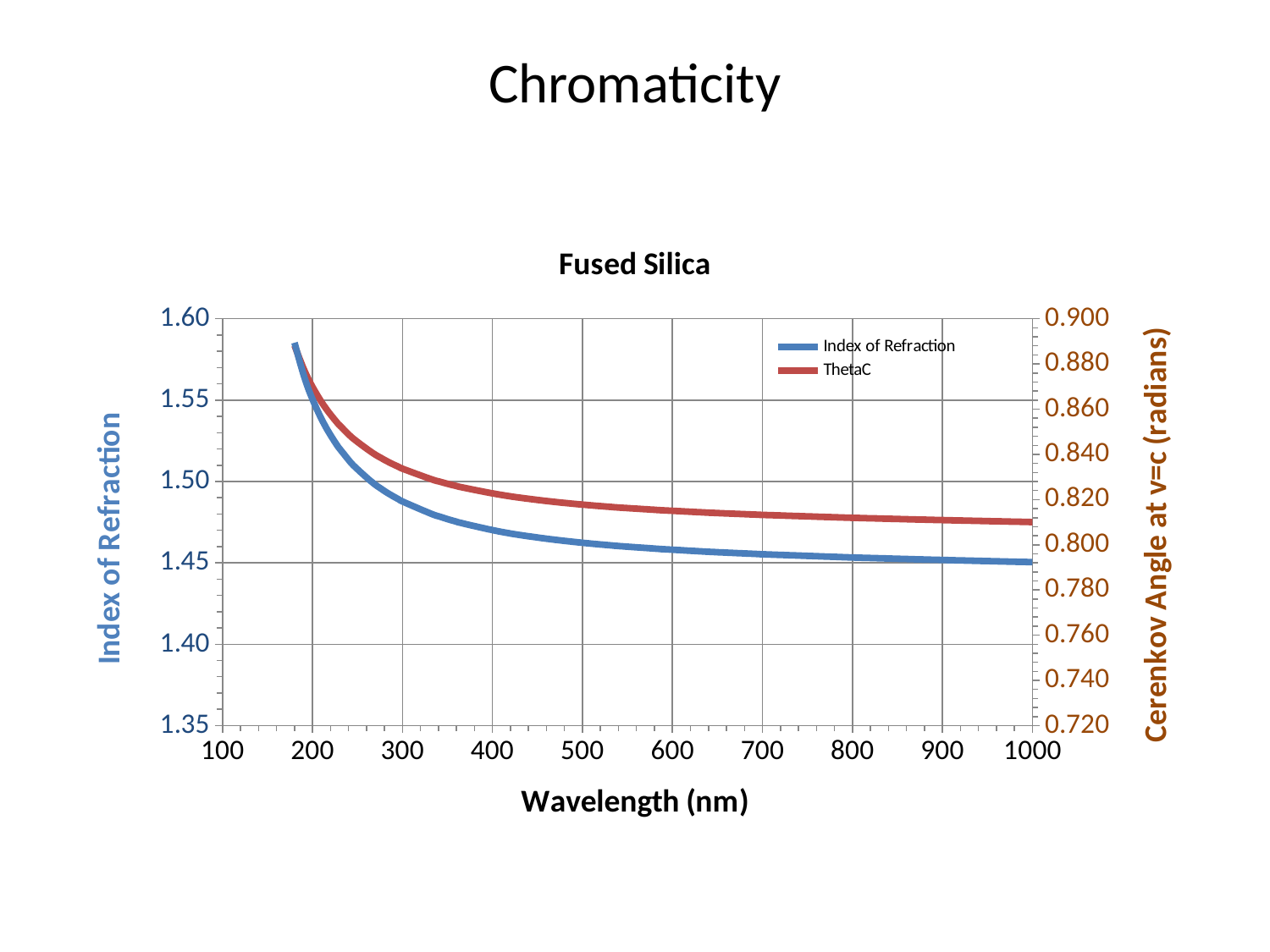
How many series does the legend of the Fused Silica chart list? 2 What is the title of the chart on the slide? Fused Silica Is the ThetaC value at 500 nm greater or less than 0.800? greater Is the Index of Refraction at 400 nm greater or less than 1.45? greater Does the Index of Refraction rise or fall as wavelength increases? Fall Is the Index of Refraction at 600 nm greater or less than 1.50? less What is the label of the x axis of the Fused Silica chart? Wavelength (nm) Does ThetaC rise or fall as wavelength increases along the x axis? Fall What kind of chart is shown on the slide? Line chart